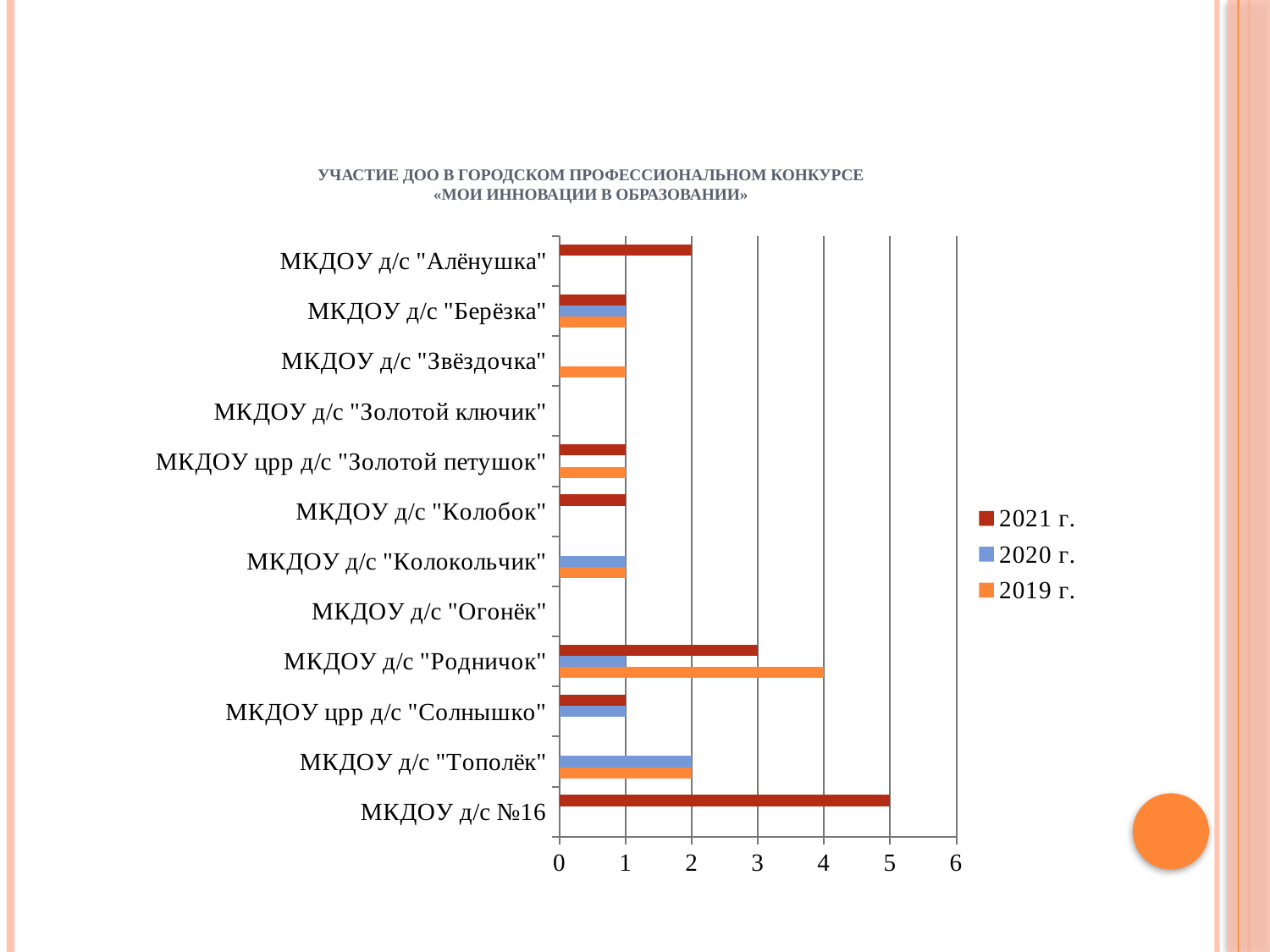
What is the value for МКДОУ д/с №16 in 2021 г.? 5 What is the value for МКДОУ д/с "Родничок" in 2019 г.? 4 Which institution has the highest value for 2019 г.? МКДОУ д/с "Родничок" What is the difference between the 2019 г. and 2021 г. values for МКДОУ д/с "Родничок"? 1 Is the 2021 г. value for МКДОУ д/с №16 greater or less than 4? greater Which is larger: the 2021 г. value for МКДОУ д/с "Алёнушка" or the 2021 г. value for МКДОУ д/с "Родничок"? МКДОУ д/с "Родничок" How many categories (institutions) are shown on the chart? 12 Which series is shown in orange in the legend? 2019 г. Which institution has the highest value for 2021 г.? МКДОУ д/с №16 How many series does the legend list? 3 What kind of chart is shown on the slide? bar chart What is the value for МКДОУ д/с "Тополёк" in 2020 г.? 2